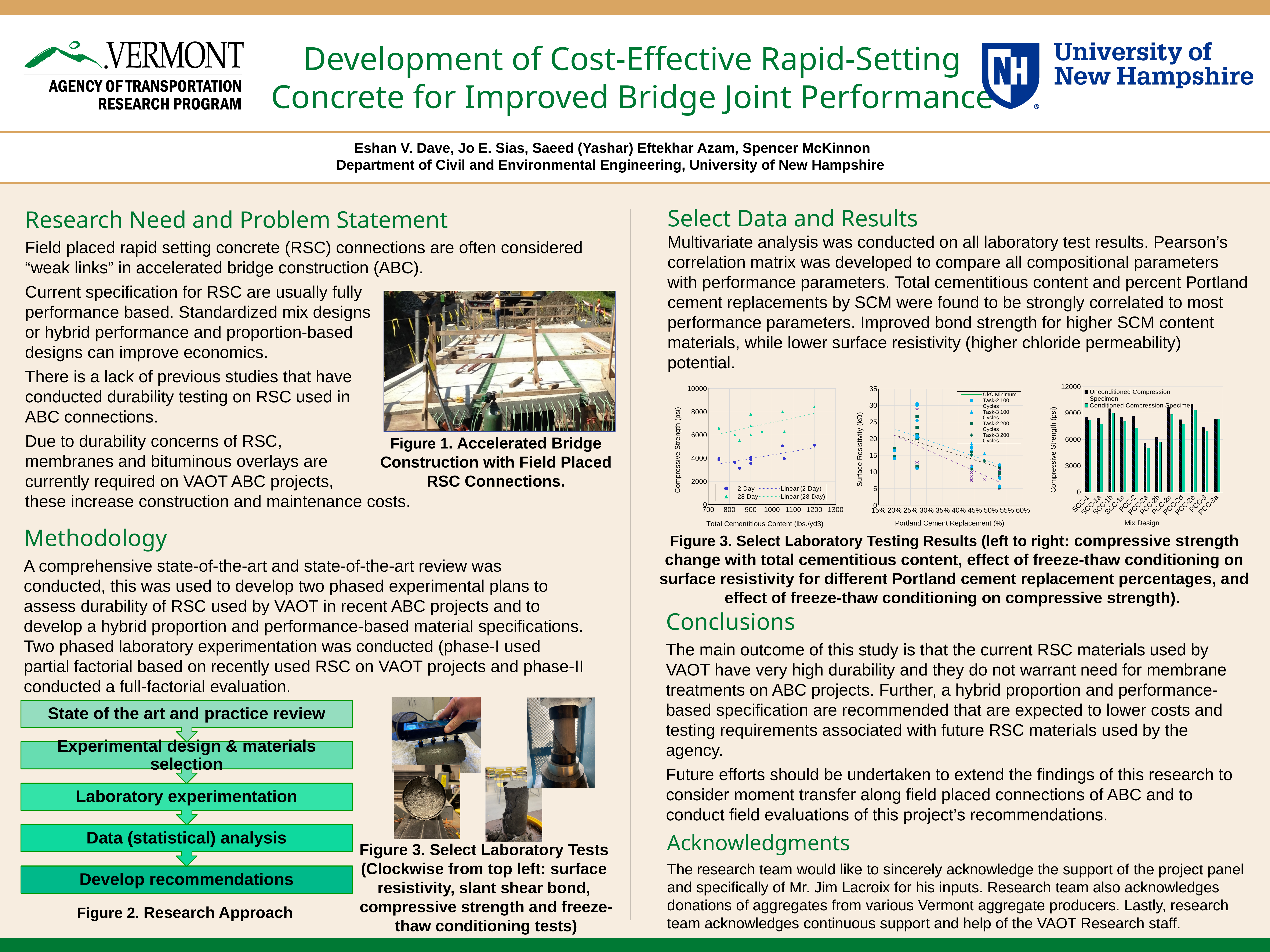
In the rightmost chart of Figure 3, is the Unconditioned Compression Specimen value for PCC-2b greater or less than 9000? less In the leftmost chart of Figure 3, how many series does the legend list? 4 In the rightmost chart of Figure 3, how many series does the legend list? 2 In the rightmost chart of Figure 3, which mix design has the lowest Unconditioned Compression Specimen value? PCC-2a In the rightmost chart of Figure 3, is the Unconditioned Compression Specimen value for PCC-2e greater or less than 9000? greater In the middle chart of Figure 3, do the surface resistivity values generally rise or fall as Portland cement replacement increases? fall In the rightmost chart of Figure 3, is the Unconditioned Compression Specimen value for PCC-2a greater or less than 6000? less In the rightmost chart of Figure 3, which has the larger Unconditioned Compression Specimen value, PCC-2c or PCC-2a? PCC-2c In the rightmost chart of Figure 3, how many mix designs are shown on the x axis? 12 In the rightmost chart of Figure 3, what is the label of the y axis? Compressive Strength (psi) In the rightmost chart of Figure 3 (compressive strength by mix design), what kind of chart is shown? bar chart In the leftmost chart of Figure 3, what is the label of the x axis? Total Cementitious Content (lbs./yd3)